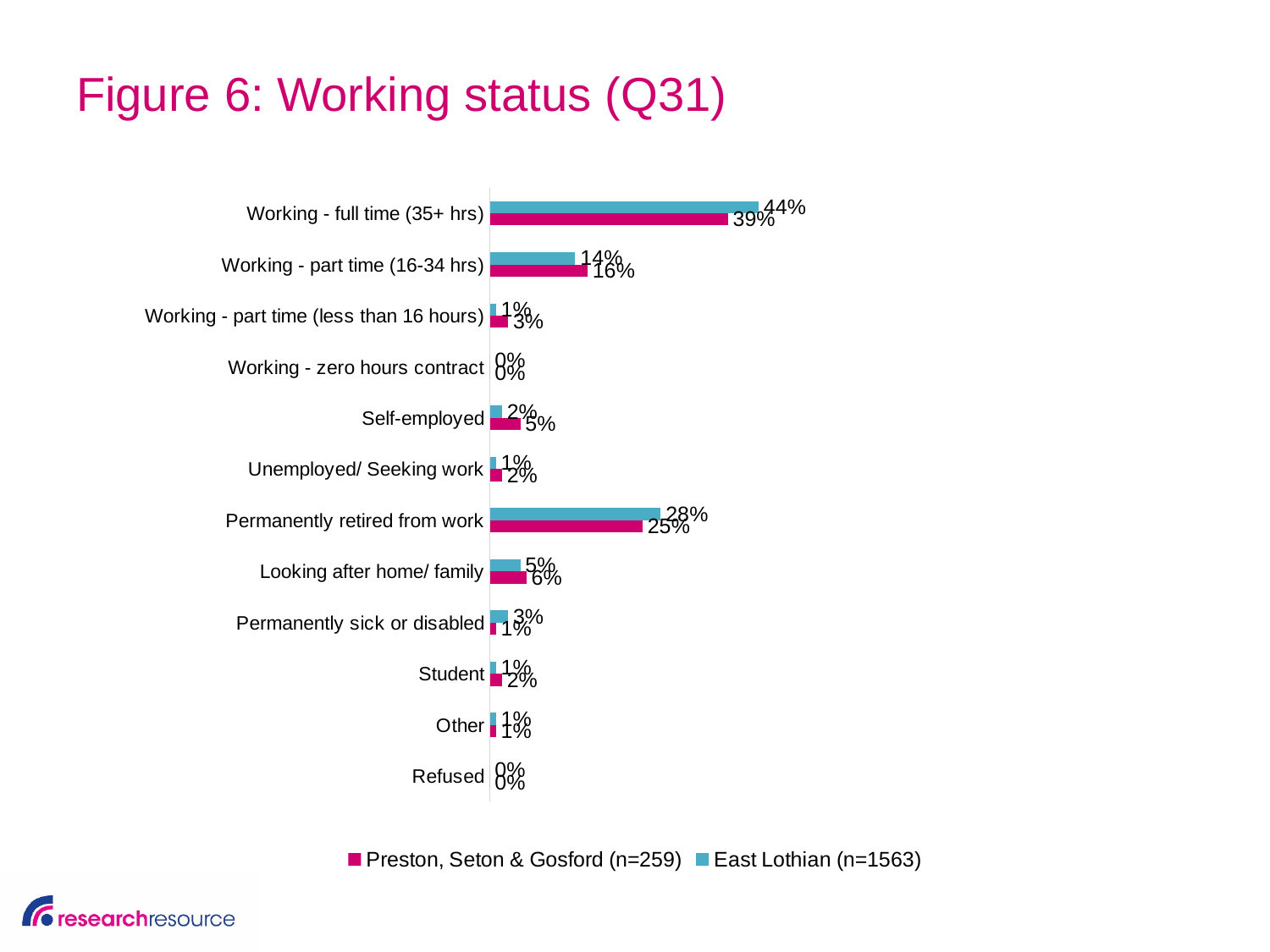
What kind of chart is shown on the slide? Bar chart What is the value for Self-employed for Preston, Seton & Gosford (n=259)? 5% What is the difference between the Preston, Seton & Gosford and East Lothian values for Working - part time (16-34 hrs)? 2% What is the value for Permanently retired from work for Preston, Seton & Gosford (n=259)? 25% What is the title of the chart on the slide? Figure 6: Working status (Q31) What is the difference between the East Lothian and Preston, Seton & Gosford values for Working - full time (35+ hrs)? 5% How many working status categories are shown on the chart? 12 What is the value for Working - full time (35+ hrs) for East Lothian (n=1563)? 44% Which category has the highest value for East Lothian (n=1563)? Working - full time (35+ hrs) For Permanently retired from work, which series has the larger value: Preston, Seton & Gosford or East Lothian? East Lothian How many series does the legend list? 2 What is the value for Working - full time (35+ hrs) for Preston, Seton & Gosford (n=259)? 39%